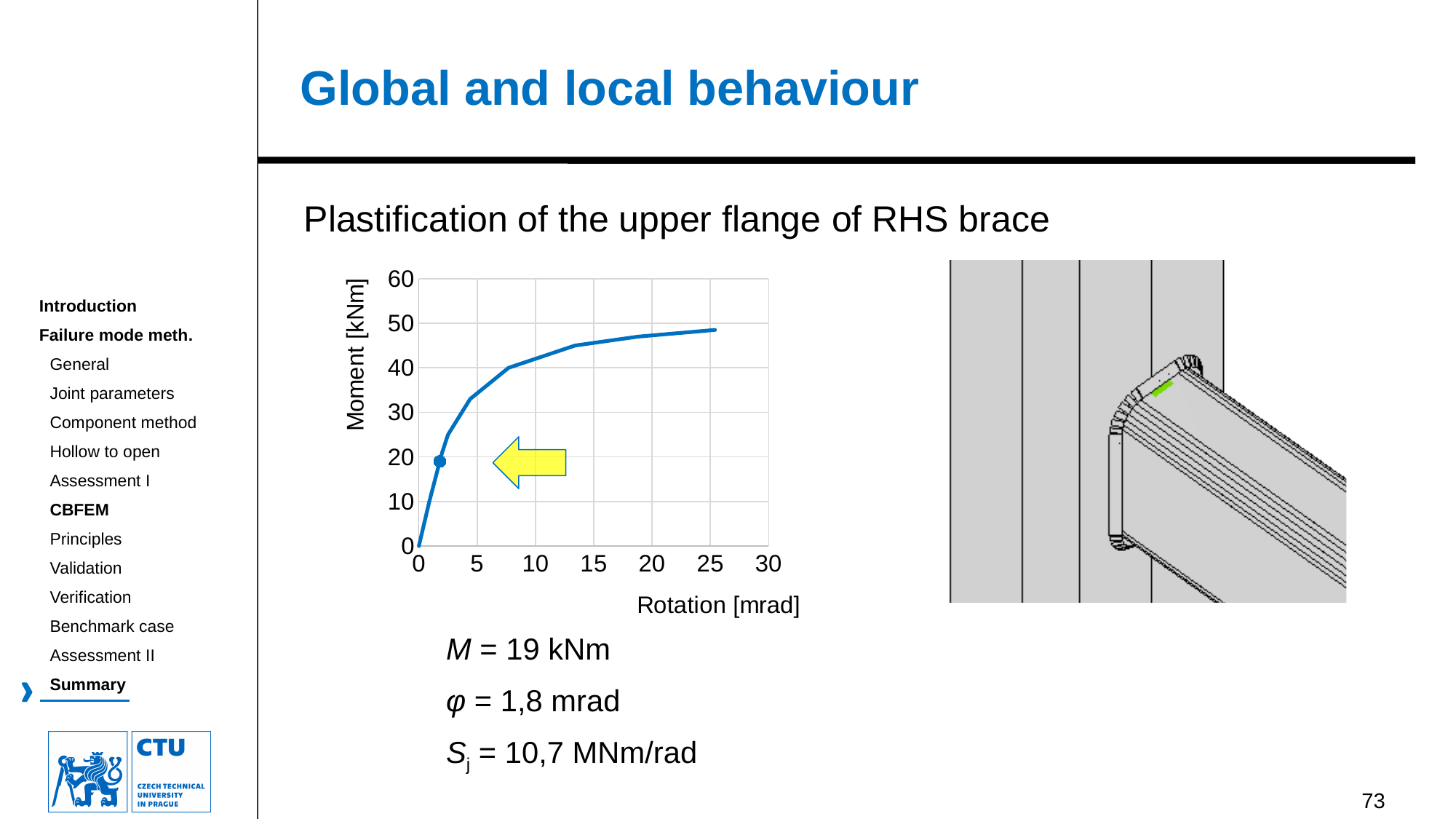
What is the label of the vertical axis of the chart? Moment [kNm] What is the label of the horizontal axis of the chart? Rotation [mrad] Is the moment at a rotation of 10 mrad greater or less than 30 kNm? greater Is the moment at the highlighted point greater or less than 20 kNm? less What is the rotation at the highlighted point on the curve? 1,8 mrad What kind of chart is shown on the slide? line chart Is the moment at a rotation of 25 mrad greater or less than 40 kNm? greater Does the moment rise or fall as the rotation increases along the x axis? rise What is the moment at the highlighted point on the curve? 19 kNm What is the highest tick value shown on the vertical axis? 60